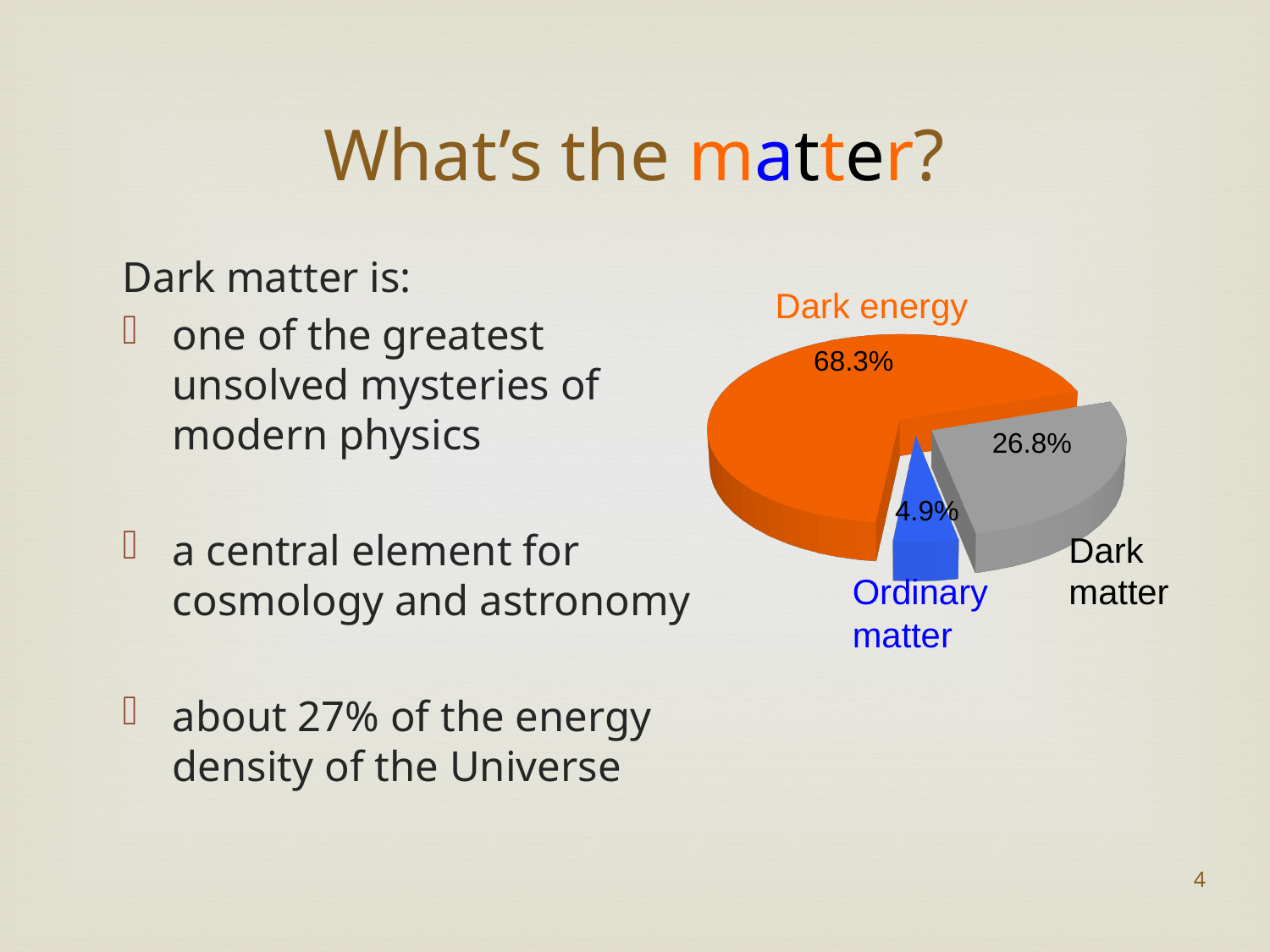
What type of chart is shown on the slide? pie chart What colour is the Ordinary matter slice? blue How many slices does the pie chart have? 3 What is the difference between the Dark energy share and the Dark matter share? 41.5% What colour is the Dark energy slice? orange What is the difference between the Dark matter share and the Ordinary matter share? 21.9% Which slice of the pie is the smallest? Ordinary matter Which slice of the pie is the largest? Dark energy Which is larger, the Dark matter slice or the Ordinary matter slice? Dark matter What share of the pie does Ordinary matter represent? 4.9% What share of the pie does Dark matter represent? 26.8% What share of the pie does Dark energy represent? 68.3%